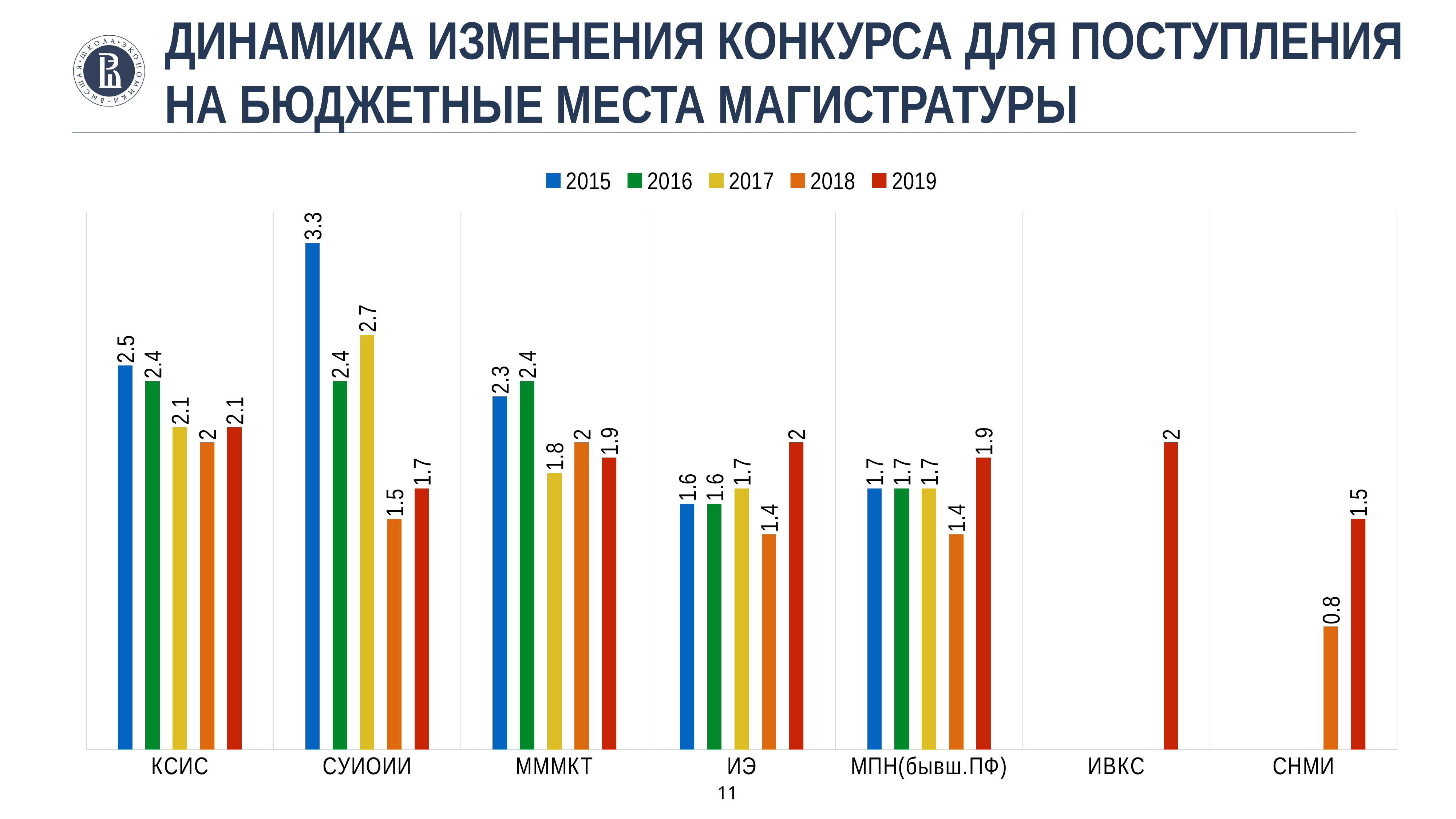
What is the value for СУИОИИ in 2015? 3.3 What is the value for ИЭ in 2019? 2 What is the difference between the 2015 and 2018 values for СУИОИИ? 1.8 Which category has the highest 2015 value? СУИОИИ How many series does the legend list? 5 How many categories are shown on the x axis? 7 What kind of chart is shown on the slide? bar chart Which is larger for КСИС: the 2015 value or the 2019 value? 2015 What is the value for СНМИ in 2018? 0.8 What is the value for МММКТ in 2017? 1.8 Do the values for СУИОИИ rise or fall from 2017 to 2018? fall Which category has the lowest 2018 value? СНМИ